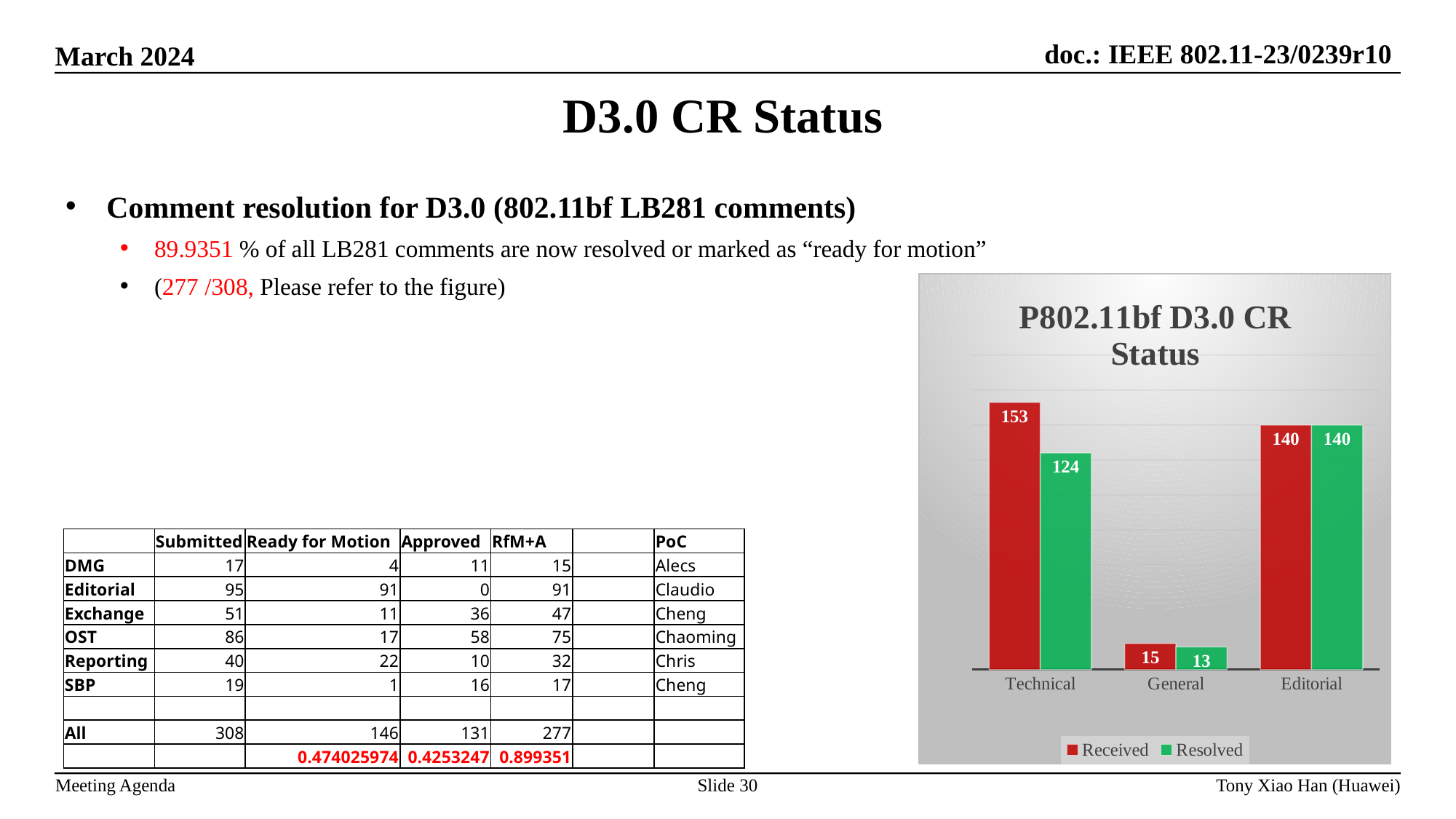
Which is larger, the Received value for Technical or the Received value for Editorial? Technical How many series does the legend list? 2 What is the Resolved value for Technical? 124 What is the difference between Received and Resolved for Technical? 29 What type of chart is shown? Bar chart What is the difference between Received and Resolved for General? 2 What is the Resolved value for Editorial? 140 What is the Received value for Technical? 153 What is the Received value for General? 15 Which category has the lowest Resolved value? General Which category has the highest Received value? Technical How many categories are shown on the x axis? 3